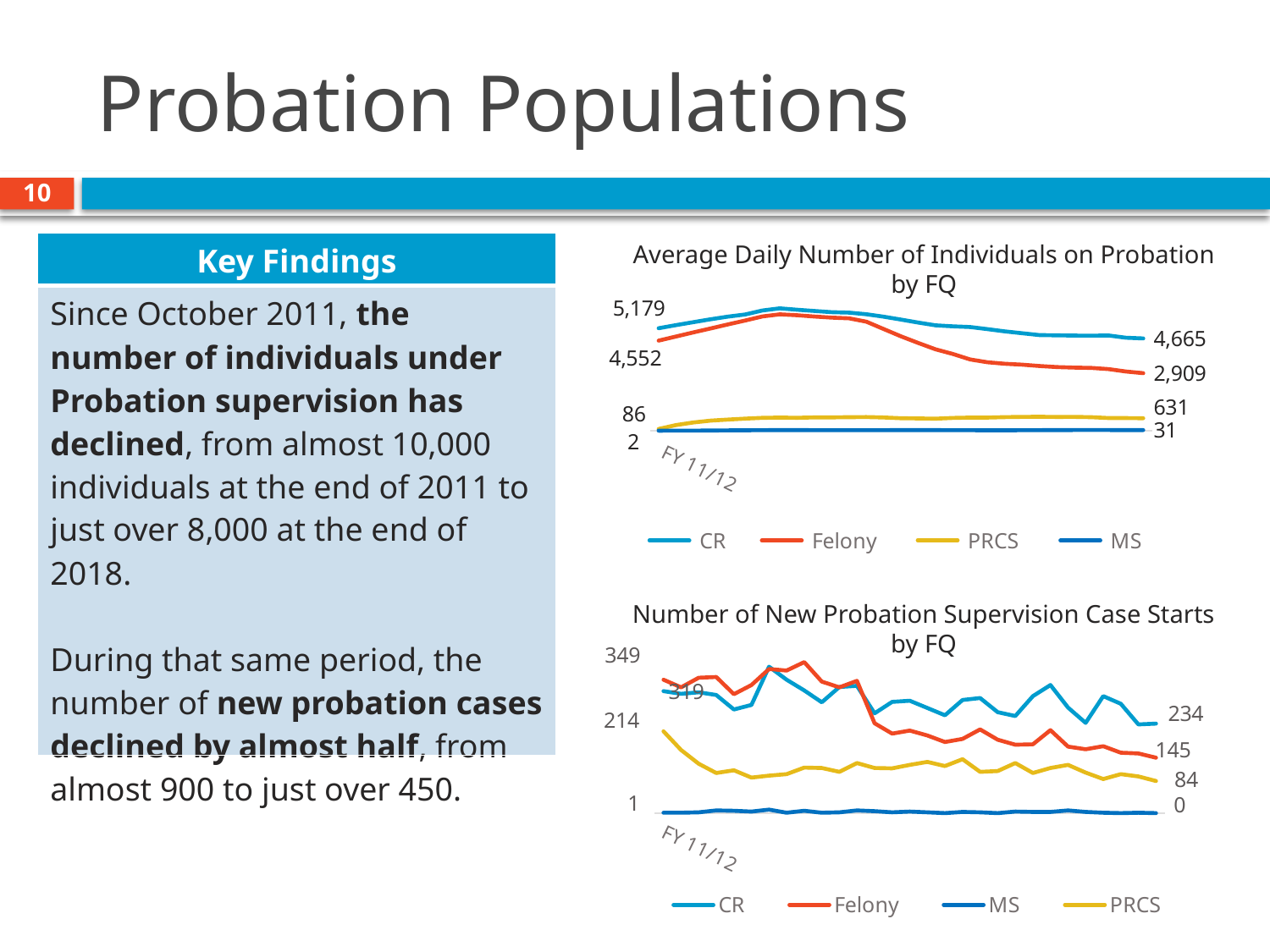
In the 'Average Daily Number of Individuals on Probation by FQ' chart, what is the difference between the first and last labelled values for CR (5,179 and 4,665)? 514 In the 'Number of New Probation Supervision Case Starts by FQ' chart, what is the last labelled value for PRCS? 84 In the 'Average Daily Number of Individuals on Probation by FQ' chart, which series has the highest value at the end of the period? CR What kind of chart is the 'Average Daily Number of Individuals on Probation by FQ' chart? line chart How many series does the legend of the 'Average Daily Number of Individuals on Probation by FQ' chart list? 4 In the 'Number of New Probation Supervision Case Starts by FQ' chart, what is the last labelled value for CR? 234 In the 'Number of New Probation Supervision Case Starts by FQ' chart, what is the last labelled value for Felony? 145 In the 'Average Daily Number of Individuals on Probation by FQ' chart, what is the last labelled value for MS? 31 In the 'Average Daily Number of Individuals on Probation by FQ' chart, what is the last labelled value for PRCS? 631 In the 'Average Daily Number of Individuals on Probation by FQ' chart, what is the first labelled value for CR? 5,179 In the 'Average Daily Number of Individuals on Probation by FQ' chart, what is the last labelled value for Felony? 2,909 In the 'Average Daily Number of Individuals on Probation by FQ' chart, does the Felony line overall rise or fall from the first to the last quarter? fall